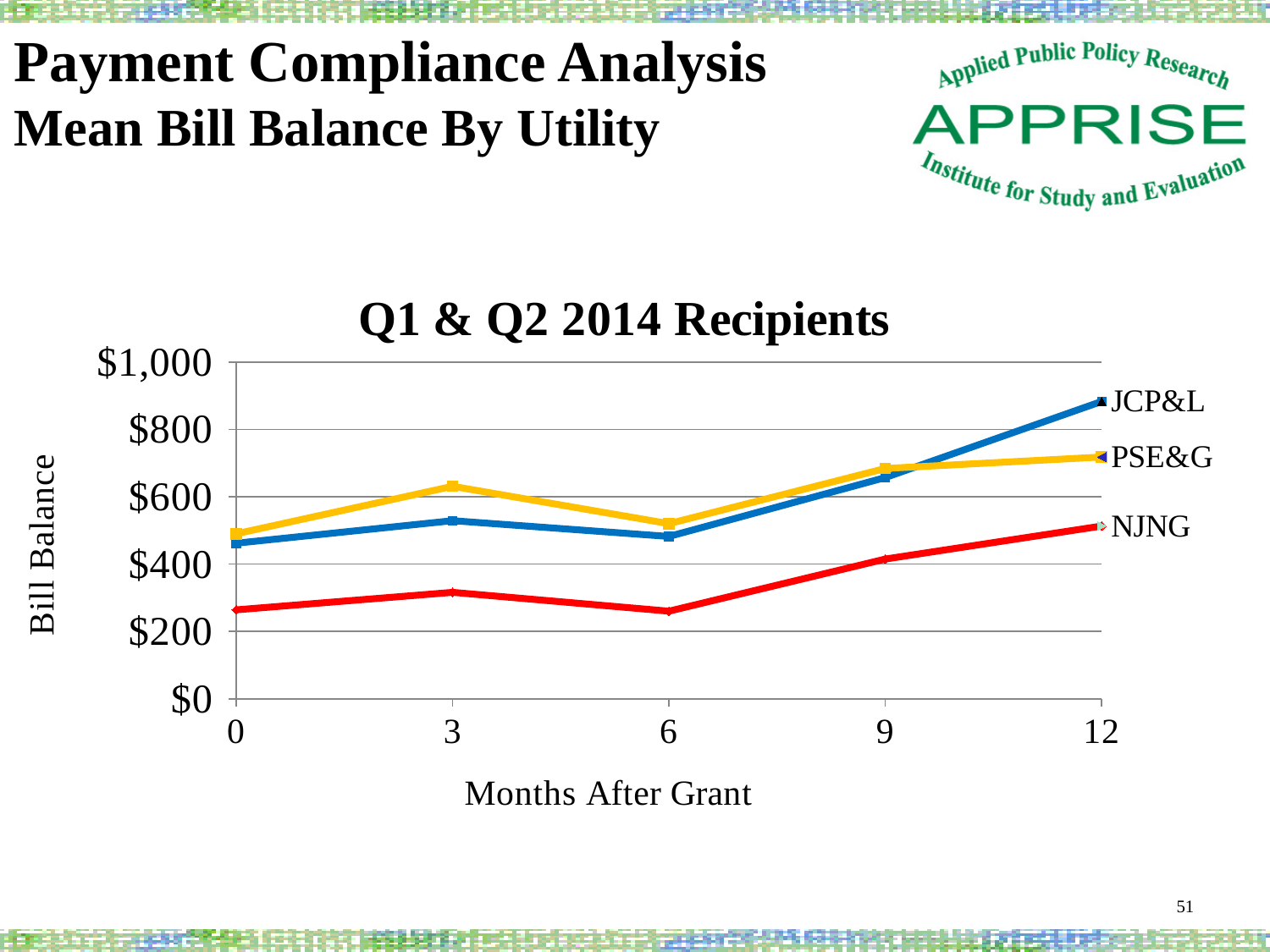
How many points in time (months after grant) are shown on the x axis? 5 What kind of chart is shown on the slide? line chart Does the NJNG bill balance rise or fall between 6 and 12 months after grant? rise Is the NJNG bill balance at 0 months after grant greater or less than $400? less Is the PSE&G bill balance at 3 months after grant greater or less than $600? greater Is the JCP&L bill balance at 12 months after grant greater or less than $800? greater What is the title of the chart? Q1 & Q2 2014 Recipients At 12 months after grant, which has the higher bill balance, JCP&L or PSE&G? JCP&L Which utility has the highest mean bill balance at 12 months after grant? JCP&L Which utility has the lowest mean bill balance at 6 months after grant? NJNG How many series (utilities) are plotted on the chart? 3